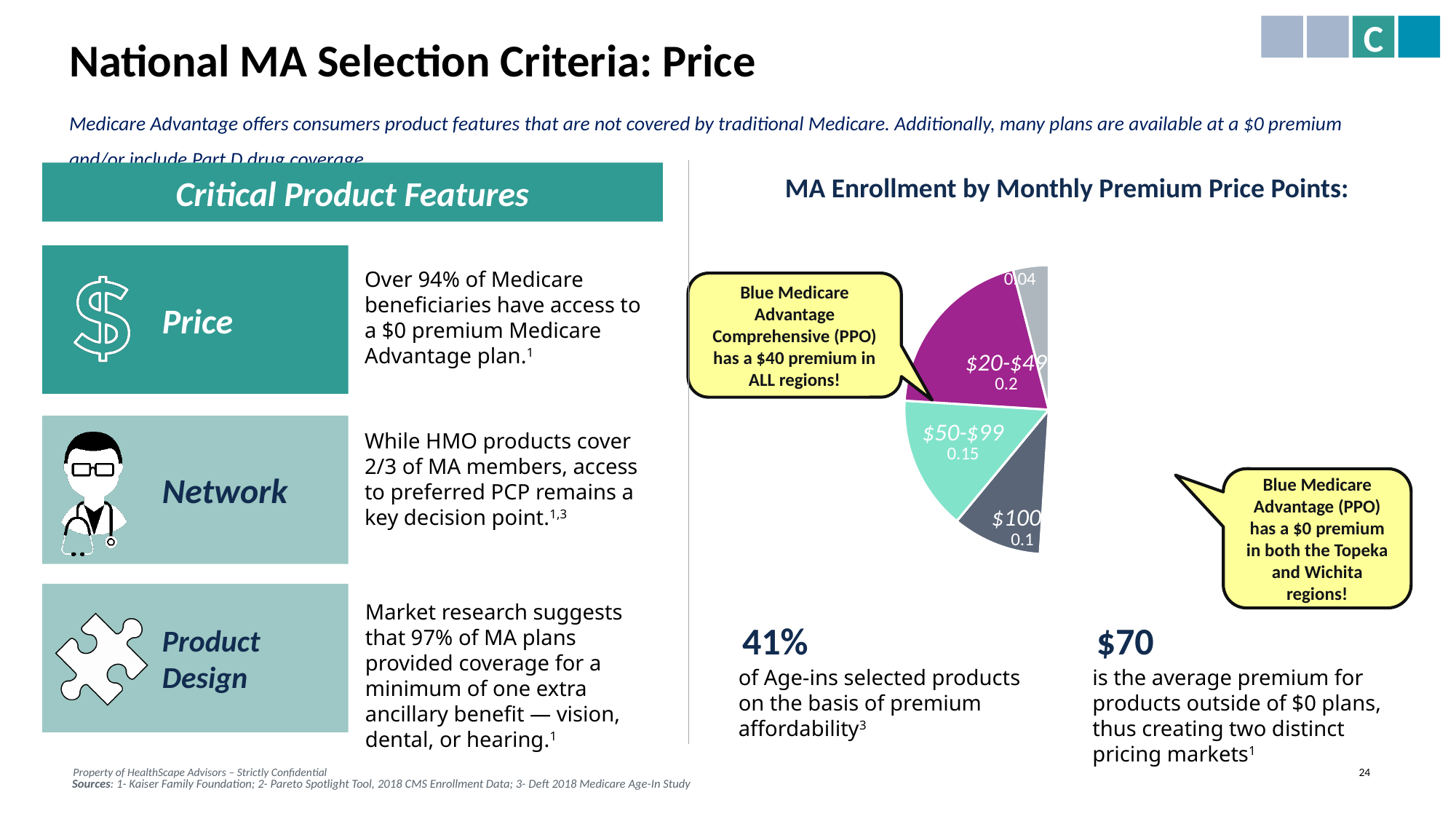
In the MA Enrollment by Monthly Premium Price Points chart, which slice is larger, $20-$49 or $50-$99? $20-$49 In the MA Enrollment by Monthly Premium Price Points chart, which of the labelled price-point slices has the highest printed value? $20-$49 In the MA Enrollment by Monthly Premium Price Points chart, what is the smallest value printed on the pie? 0.04 In the MA Enrollment by Monthly Premium Price Points chart, what value is shown for the slice labelled $100? 0.1 In the MA Enrollment by Monthly Premium Price Points chart, what is the difference between the $20-$49 value and the $50-$99 value? 0.05 In the MA Enrollment by Monthly Premium Price Points chart, which slice is larger, $50-$99 or the slice labelled $100? $50-$99 What is the title of the pie chart on the right side of the slide? MA Enrollment by Monthly Premium Price Points: What kind of chart is shown under the heading 'MA Enrollment by Monthly Premium Price Points'? pie chart How many data values are printed on the MA Enrollment by Monthly Premium Price Points pie chart? 4 In the MA Enrollment by Monthly Premium Price Points chart, what value is shown for the $20-$49 slice? 0.2 In the MA Enrollment by Monthly Premium Price Points chart, what is the difference between the $50-$99 value and the value of the slice labelled $100? 0.05 In the MA Enrollment by Monthly Premium Price Points chart, what value is shown for the $50-$99 slice? 0.15